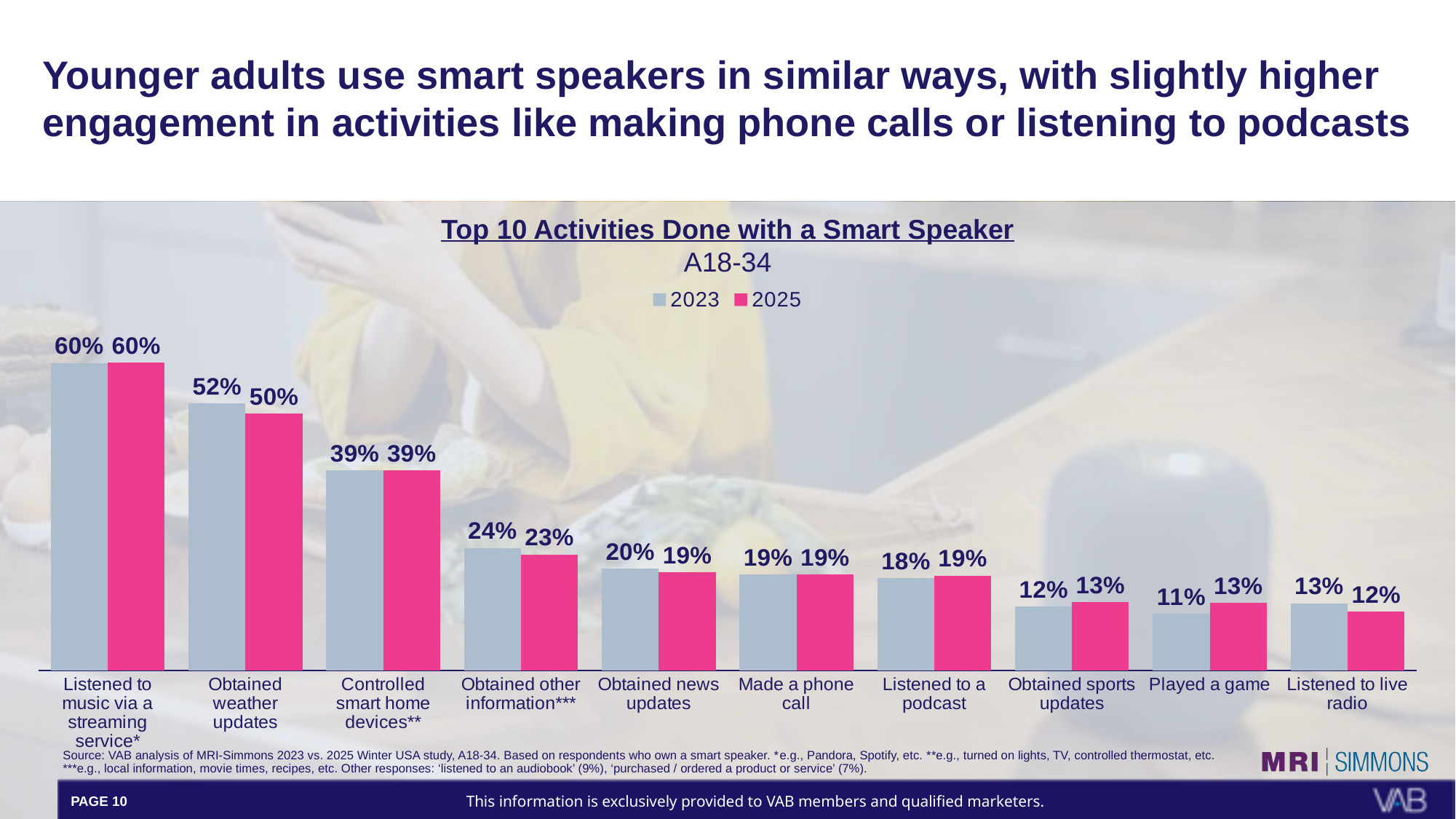
Which activity has the lowest value in the 2023 series? Played a game What is the 2025 value for 'Obtained weather updates'? 50% How many series does the legend list? 2 Do the 2023 values generally rise or fall from left to right across the activities? Fall What kind of chart is shown on the slide? Bar chart Which activity has the highest value in the 2023 series? Listened to music via a streaming service* What is the difference between the 2023 and 2025 values for 'Obtained weather updates'? 2% Which is larger for 'Listened to live radio': the 2023 value or the 2025 value? 2023 What is the 2025 value for 'Played a game'? 13% How many activities are shown on the x axis? 10 What is the title of the chart? Top 10 Activities Done with a Smart Speaker What is the 2023 value for 'Made a phone call'? 19%